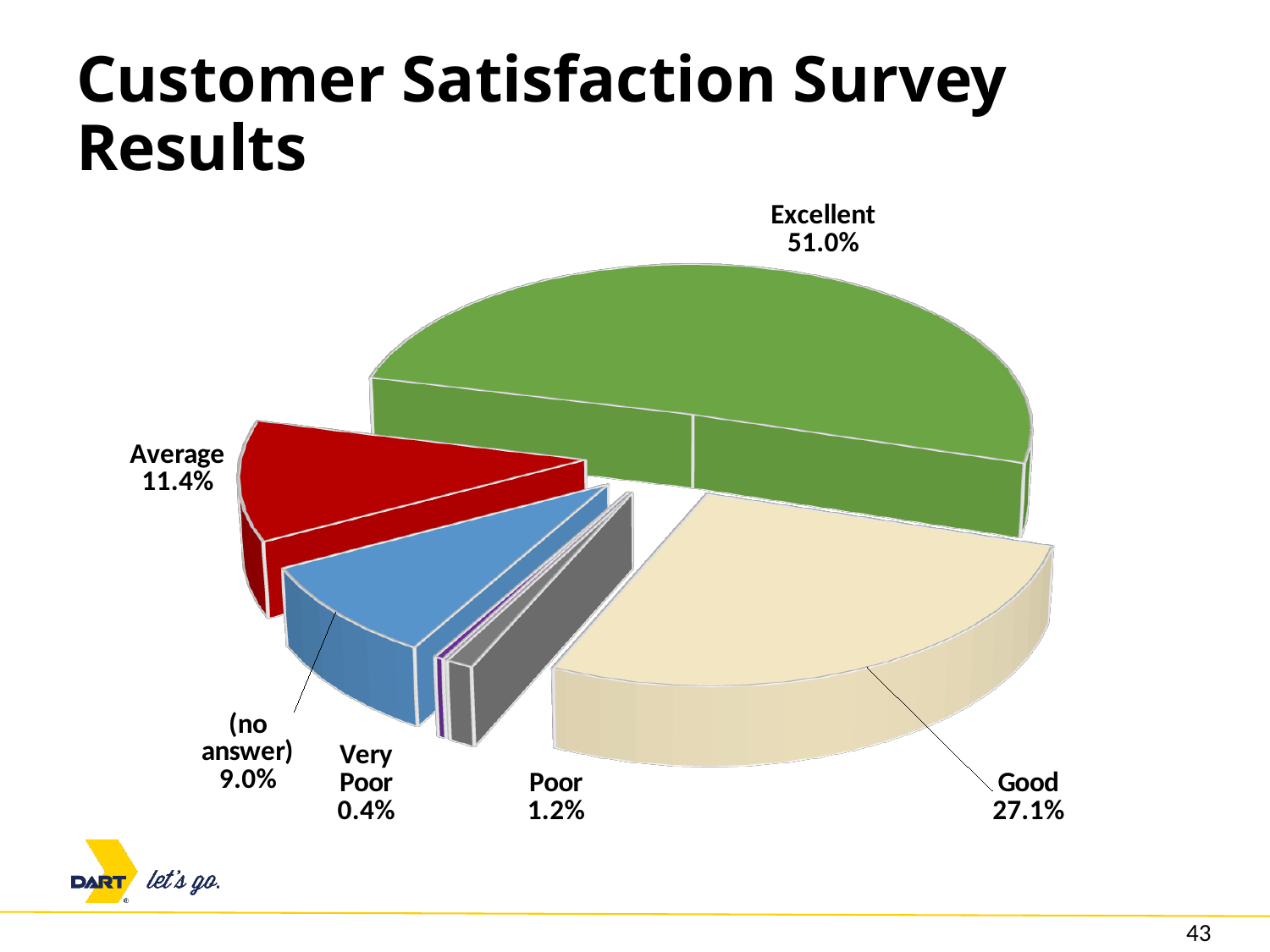
How many slices does the pie chart have? 6 What kind of chart is shown on the slide? pie chart What share of responses is labelled Average? 11.4% What is the title of the slide containing the chart? Customer Satisfaction Survey Results Which category has the largest slice of the pie? Excellent What share of responses is labelled Excellent? 51.0% What is the difference in percentage points between the Excellent and Good slices? 23.9 Which slice is larger, Average or (no answer)? Average What share of responses is labelled Good? 27.1% What share of responses is labelled Very Poor? 0.4% Which category has the smallest slice of the pie? Very Poor What share of responses is labelled (no answer)? 9.0%